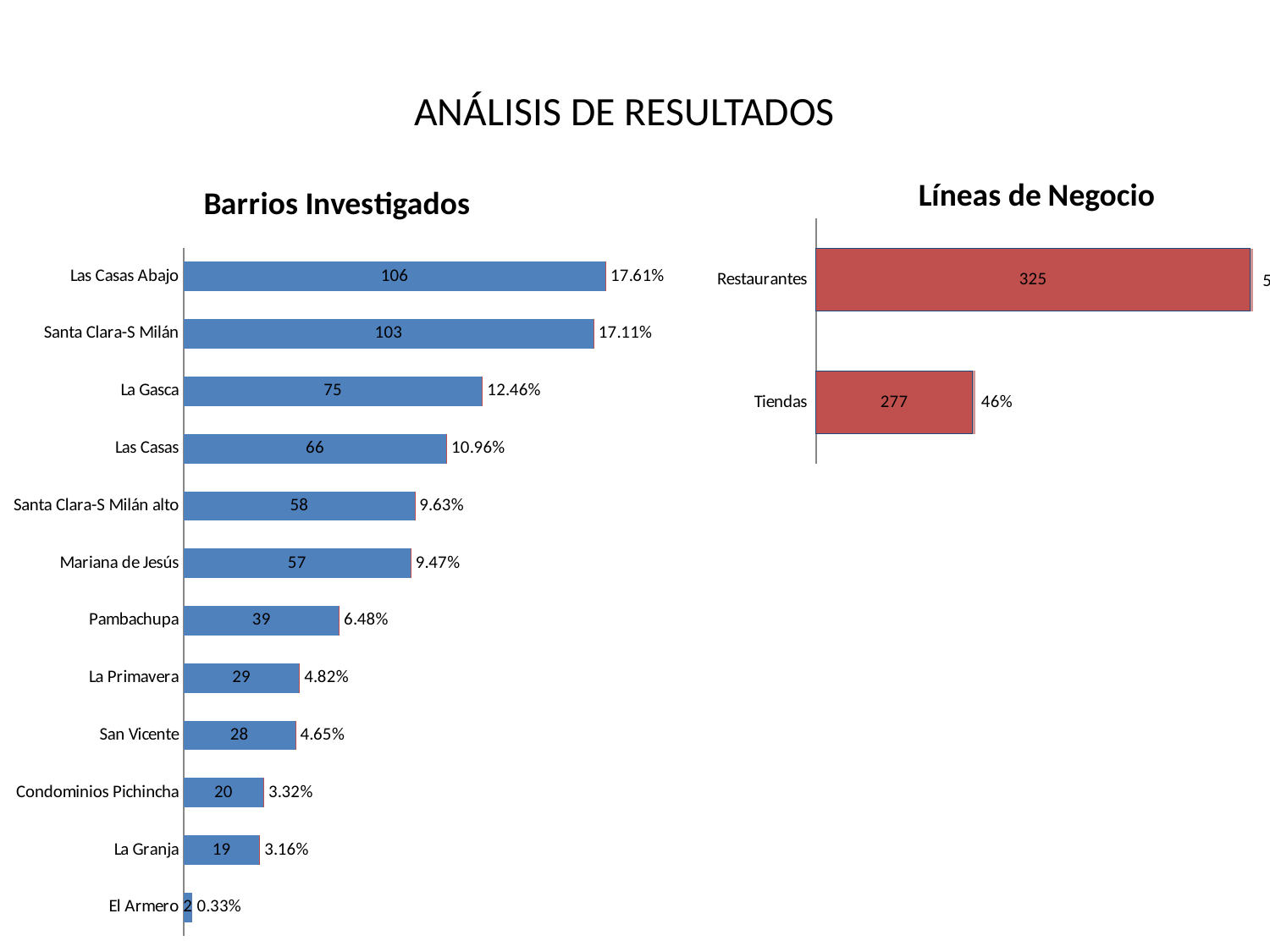
In the 'Barrios Investigados' chart, which barrio has the lowest value? El Armero In the 'Líneas de Negocio' chart, what percentage is shown for Tiendas? 46% In the 'Líneas de Negocio' chart, what is the value for Restaurantes? 325 What kind of chart is 'Barrios Investigados'? Bar chart In the 'Líneas de Negocio' chart, what is the difference between the values for Restaurantes and Tiendas? 48 In the 'Barrios Investigados' chart, which is larger, the value for Pambachupa or the value for La Primavera? Pambachupa How many barrios are shown in the 'Barrios Investigados' chart? 12 In the 'Barrios Investigados' chart, what is the value for La Gasca? 75 In the 'Barrios Investigados' chart, what percentage is shown for Mariana de Jesús? 9.47% In the 'Barrios Investigados' chart, which barrio has the highest value? Las Casas Abajo How many categories are shown in the 'Líneas de Negocio' chart? 2 In the 'Barrios Investigados' chart, what is the difference between the values for Las Casas Abajo and Santa Clara-S Milán? 3